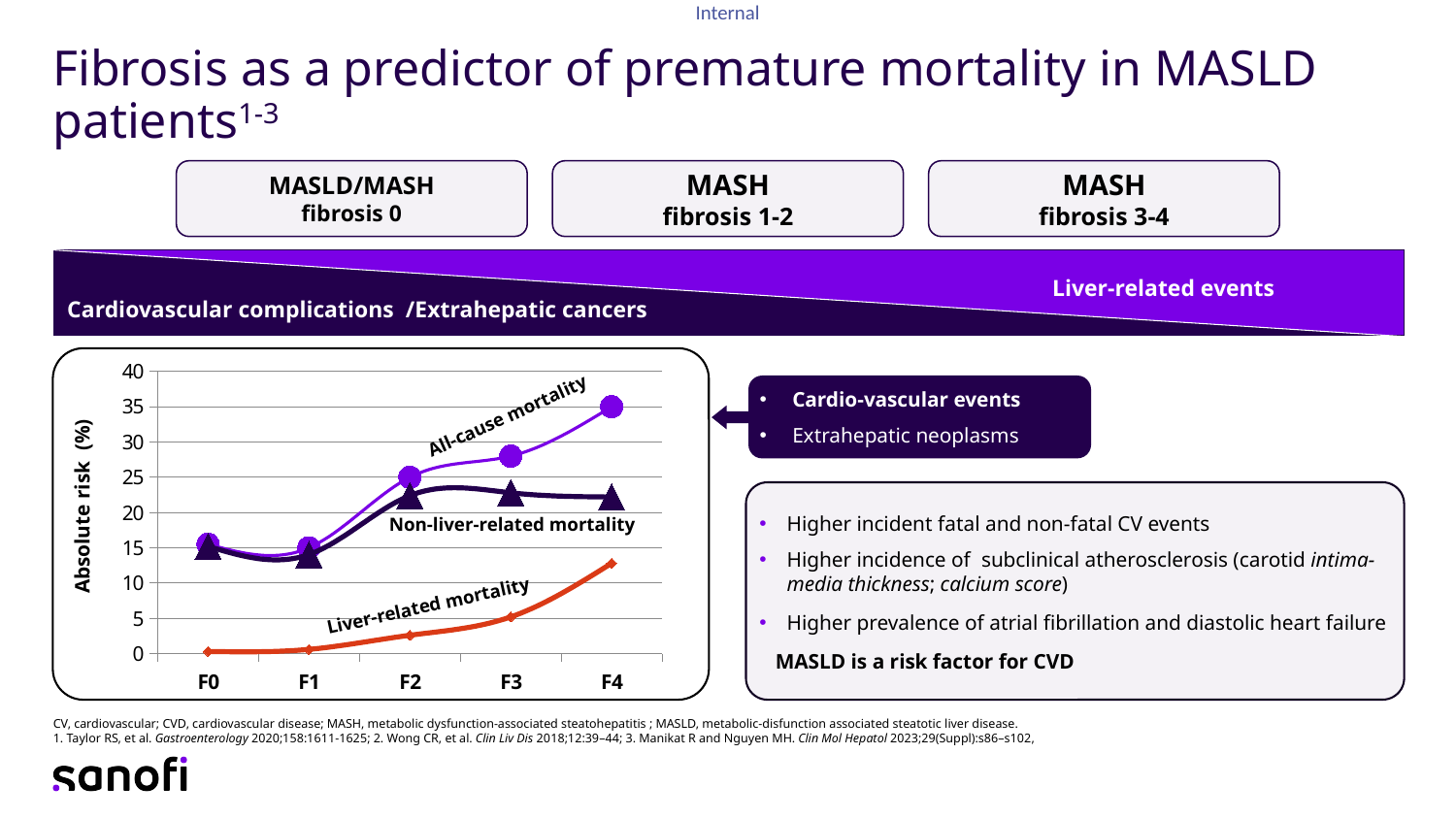
What is the label of the y axis of the chart? Absolute risk (%) What kind of chart is shown on the slide? line chart How many mortality series are plotted in the chart? 3 At F4, which is larger: all-cause mortality or liver-related mortality? all-cause mortality Is the liver-related mortality at F4 greater or less than 15? less Does all-cause mortality rise or fall from F0 to F4? rise Is the all-cause mortality at F4 greater or less than 30? greater Is the non-liver-related mortality at F2 greater or less than 20? greater Which fibrosis stage has the highest liver-related mortality? F4 Which fibrosis stage has the highest all-cause mortality? F4 How many fibrosis stages are shown on the x axis of the chart? 5